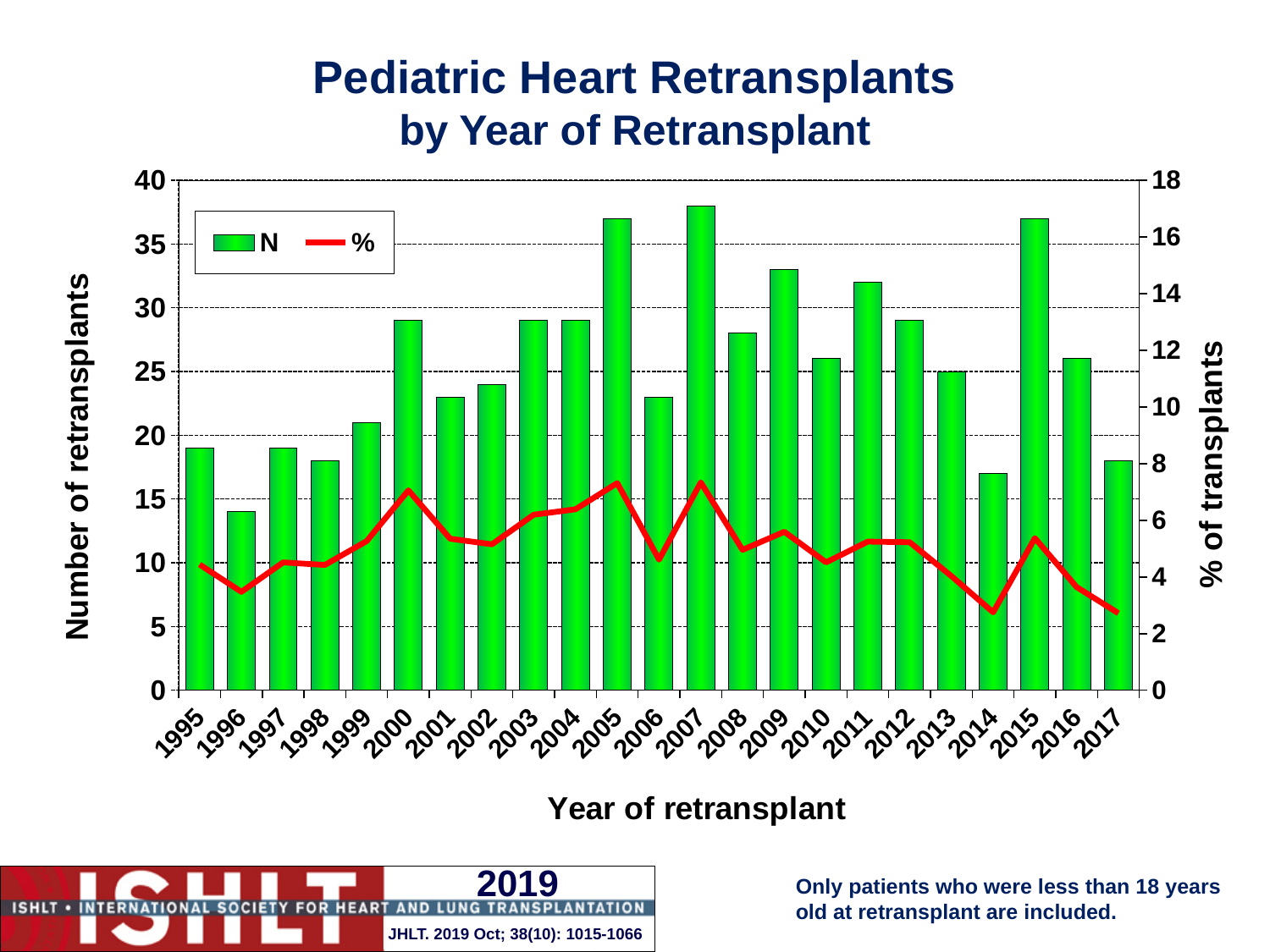
Is the number of retransplants in 2014 greater or less than 20? less Is the number of retransplants in 1996 greater or less than 15? less How many years are shown on the x axis? 23 Which year has the lowest number of retransplants? 1996 How many series does the legend list? 2 Does the % of transplants line rise or fall from 2012 to 2014? fall Which year had more retransplants, 2011 or 2014? 2011 What is the label of the right-hand y axis? % of transplants Which year had more retransplants, 2005 or 2006? 2005 Is the number of retransplants in 2007 greater or less than 35? greater What is the title of the chart? Pediatric Heart Retransplants by Year of Retransplant